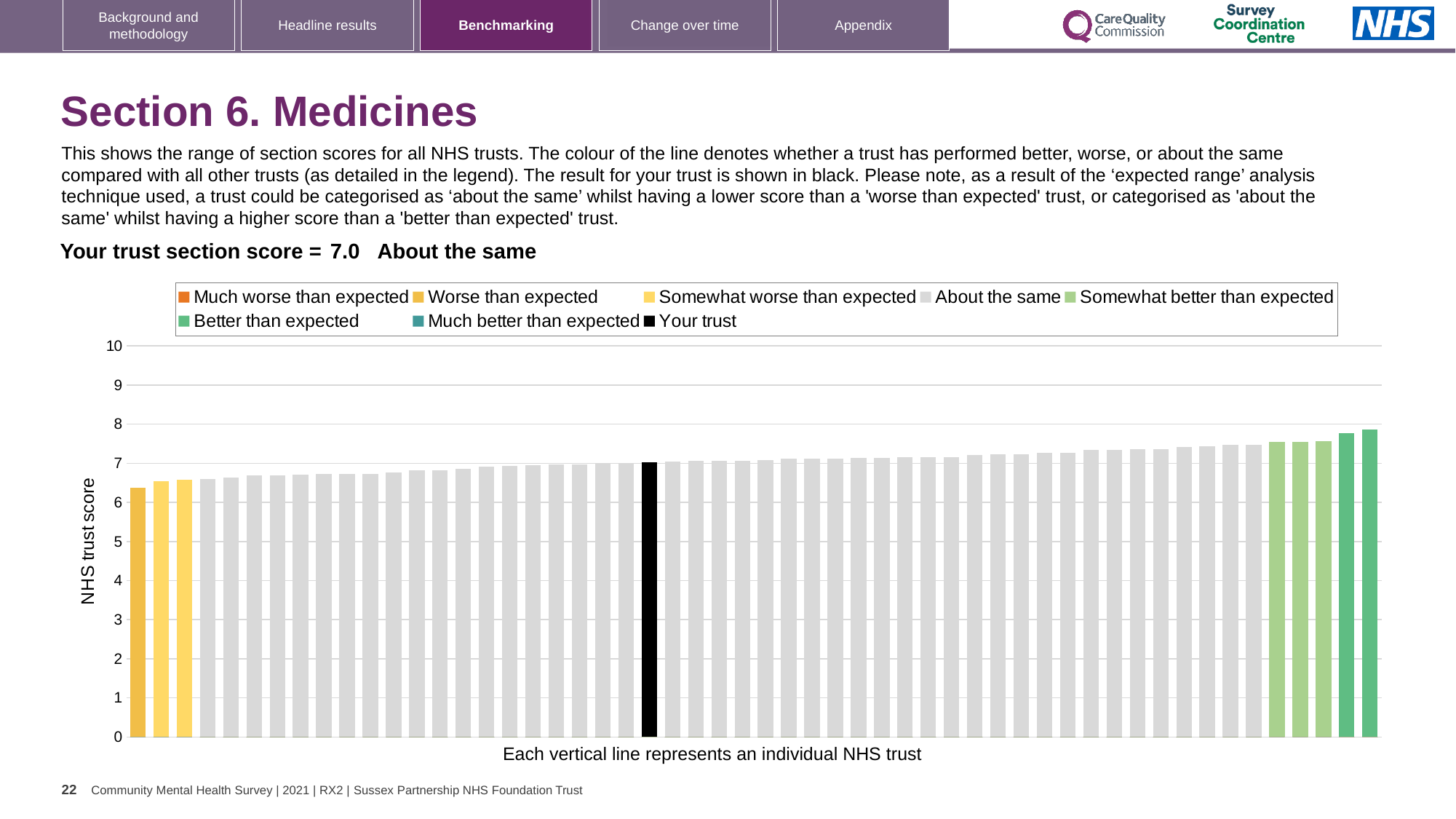
What kind of chart is shown on the slide? Bar chart What is the section score for your trust shown on the slide? 7.0 Where is the lowest-scoring trust's bar positioned on the chart? Leftmost Which bar is the highest: the leftmost bar or the rightmost bar? Rightmost bar Is the value of the black 'Your trust' bar greater or less than 5? greater How many entries does the chart legend list? 8 Do the bar values rise or fall from left to right along the x axis? Rise Is the value of the tallest bar greater or less than 8? less What colour is the bar representing your trust? Black What is the label on the y axis of the chart? NHS trust score Is the value of the leftmost bar greater or less than 6? greater Which is taller, the black 'Your trust' bar or the leftmost yellow bar? The black 'Your trust' bar